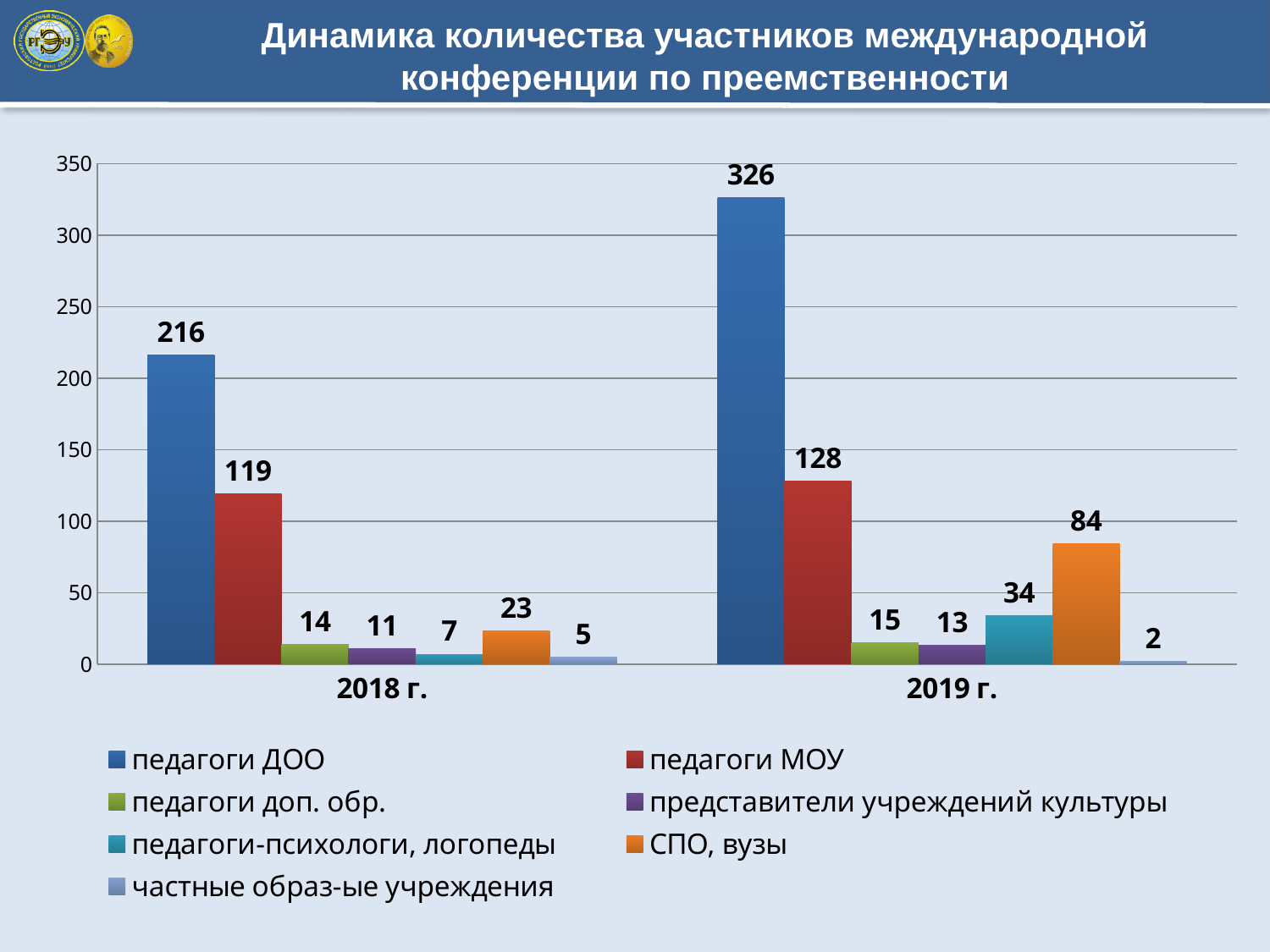
What is the value for педагоги-психологи, логопеды in 2019 г.? 34 What colour are the bars for СПО, вузы? orange What is the value for СПО, вузы in 2018 г.? 23 Which series has the highest value in 2019 г.? педагоги ДОО What is the difference between the педагоги ДОО values for 2019 г. and 2018 г.? 110 What is the value for педагоги ДОО in 2019 г.? 326 How many series does the legend list? 7 Which is larger: педагоги МОУ in 2018 г. or педагоги МОУ in 2019 г.? педагоги МОУ in 2019 г. How many year categories are shown on the x axis? 2 Does the value for педагоги ДОО rise or fall from 2018 г. to 2019 г.? rise Which series has the lowest value in 2019 г.? частные образ-ые учреждения What type of chart is shown on the slide? bar chart